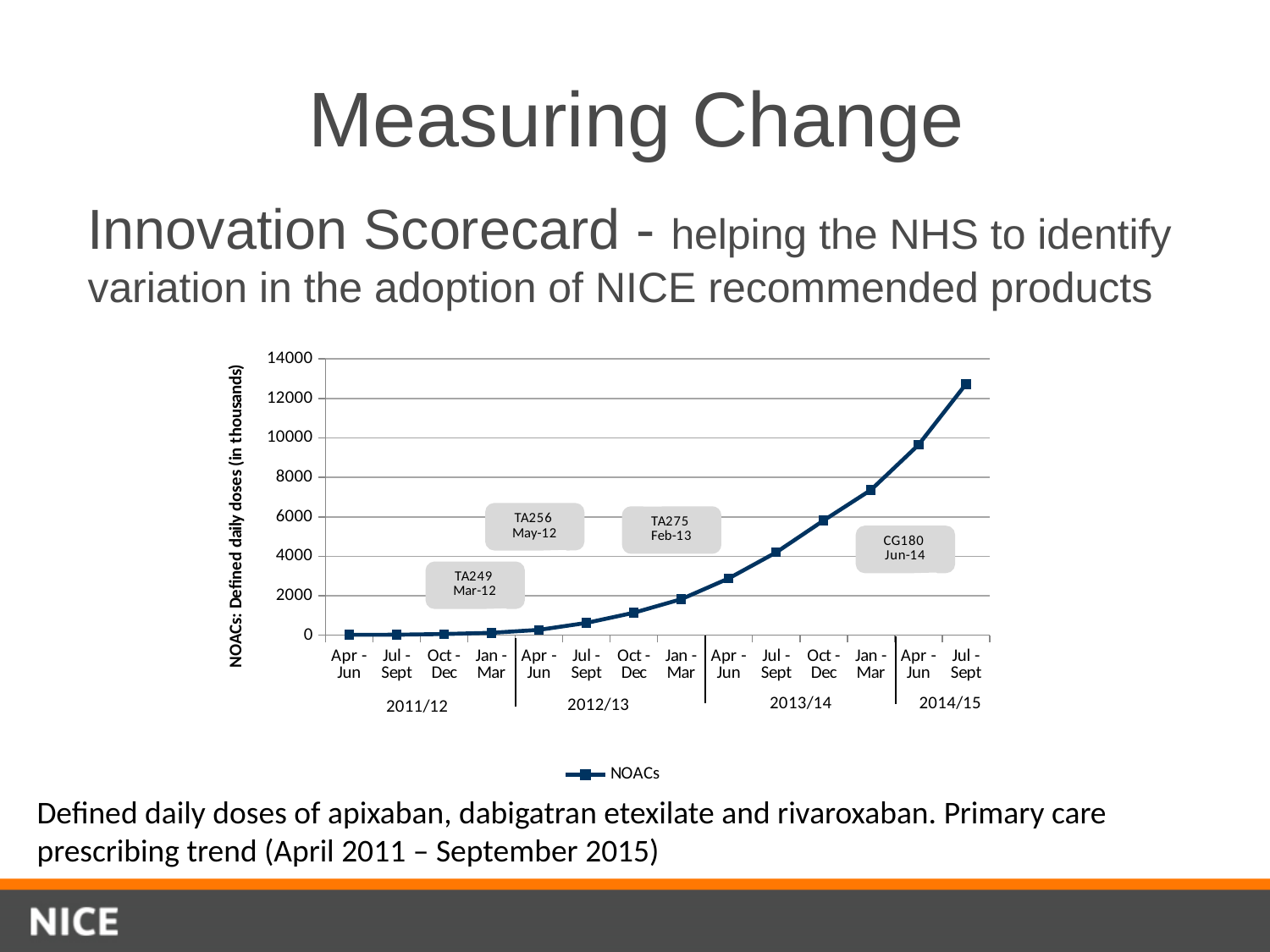
Is the value for Jul - Sept 2014/15 greater or less than 12000? greater What is the label on the vertical axis of the chart? NOACs: Defined daily doses (in thousands) Is the value for Apr - Jun 2014/15 greater or less than 8000? greater Which quarter has the highest value for NOACs? Jul - Sept 2014/15 Do the NOACs values rise or fall along the x axis from 2011/12 to 2014/15? Rise Which is larger, the value for Apr - Jun 2014/15 or the value for Oct - Dec 2013/14? Apr - Jun 2014/15 Which quarter has the lowest value for NOACs? Apr - Jun 2011/12 What kind of chart is shown on the slide? Line chart Is the value for Jan - Mar 2013/14 greater or less than 8000? less How many series does the legend list? 1 How many quarterly data points are plotted on the chart? 14